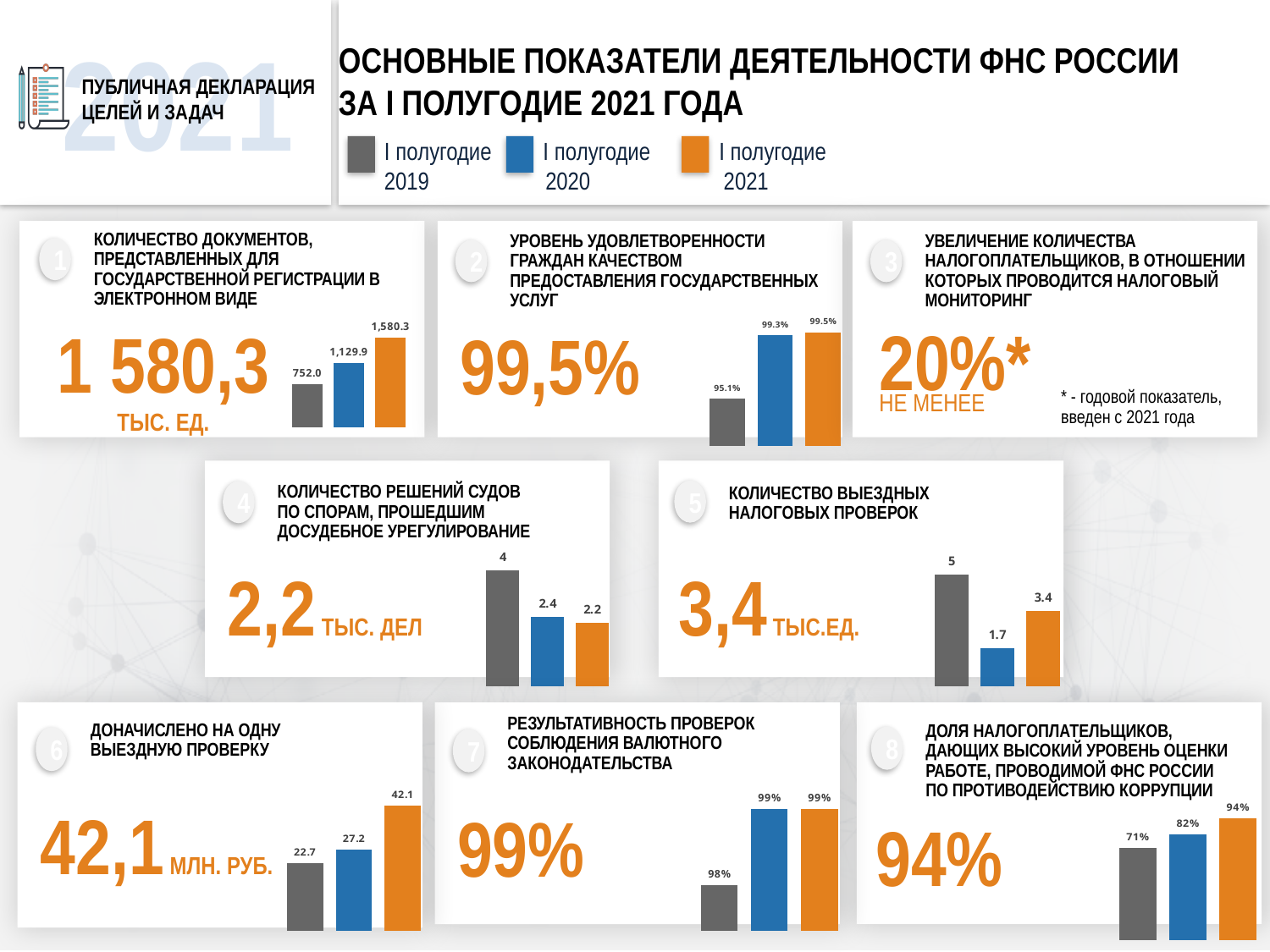
In chart 2 (Уровень удовлетворенности граждан качеством предоставления государственных услуг), what is the value for I полугодие 2020? 99.3% In chart 1 (Количество документов, представленных для государственной регистрации в электронном виде), what is the value for I полугодие 2021? 1,580.3 In chart 7 (Результативность проверок соблюдения валютного законодательства), what is the value for I полугодие 2019? 98% In chart 5 (Количество выездных налоговых проверок), which period has the lowest value? I полугодие 2020 In chart 6 (Доначислено на одну выездную проверку), do the values rise or fall from 2019 to 2021? rise In chart 6 (Доначислено на одну выездную проверку), what is the difference between the 2021 and 2020 values? 14.9 In chart 4 (Количество решений судов по спорам, прошедшим досудебное урегулирование), which period has the highest value? I полугодие 2019 In chart 4 (Количество решений судов по спорам, прошедшим досудебное урегулирование), what is the difference between the 2019 and 2021 values? 1.8 In chart 1 (Количество документов, представленных для государственной регистрации в электронном виде), what is the value for I полугодие 2019? 752.0 In chart 5 (Количество выездных налоговых проверок), what is the value for I полугодие 2021? 3.4 In chart 8 (Доля налогоплательщиков, дающих высокий уровень оценки работе ФНС по противодействию коррупции), which is larger: the 2020 value or the 2021 value? 2021 (94%) How many series does the legend at the top of the slide list? 3